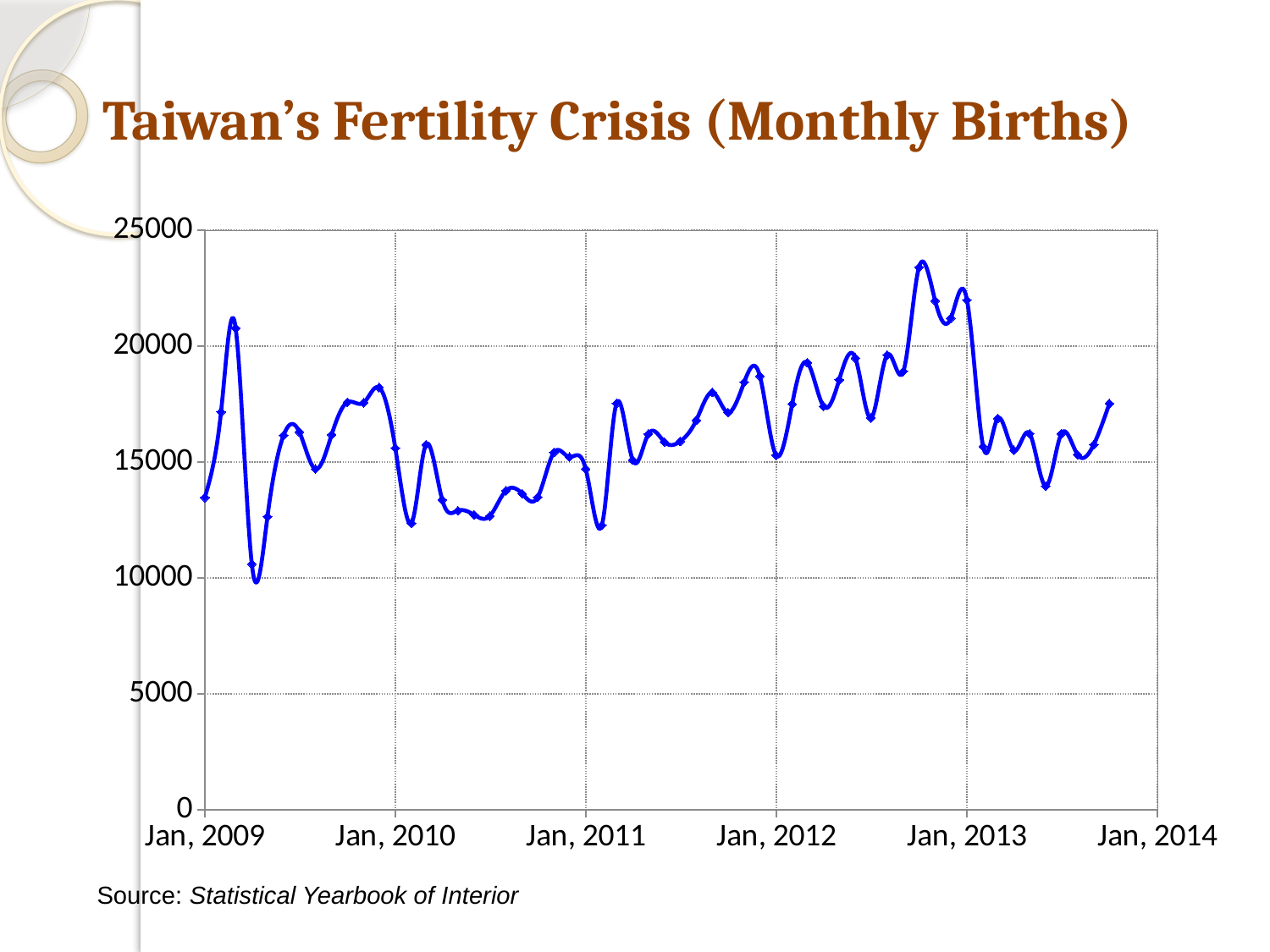
Which is larger, the value at Jan, 2012 or the value at Jan, 2009? Jan, 2012 How many lines (series) are plotted on the chart? 1 What kind of chart is shown on the slide? line chart Do the values rise or fall from the peak just before Jan, 2013 to mid-2013? fall What source is cited below the chart? Statistical Yearbook of Interior What is the highest value shown on the y axis? 25000 Is the lowest point on the line greater or less than 15000? less Is the value at Jan, 2013 greater or less than 20000? greater What is the title of the chart? Taiwan's Fertility Crisis (Monthly Births) Is the highest point on the line greater or less than 20000? greater